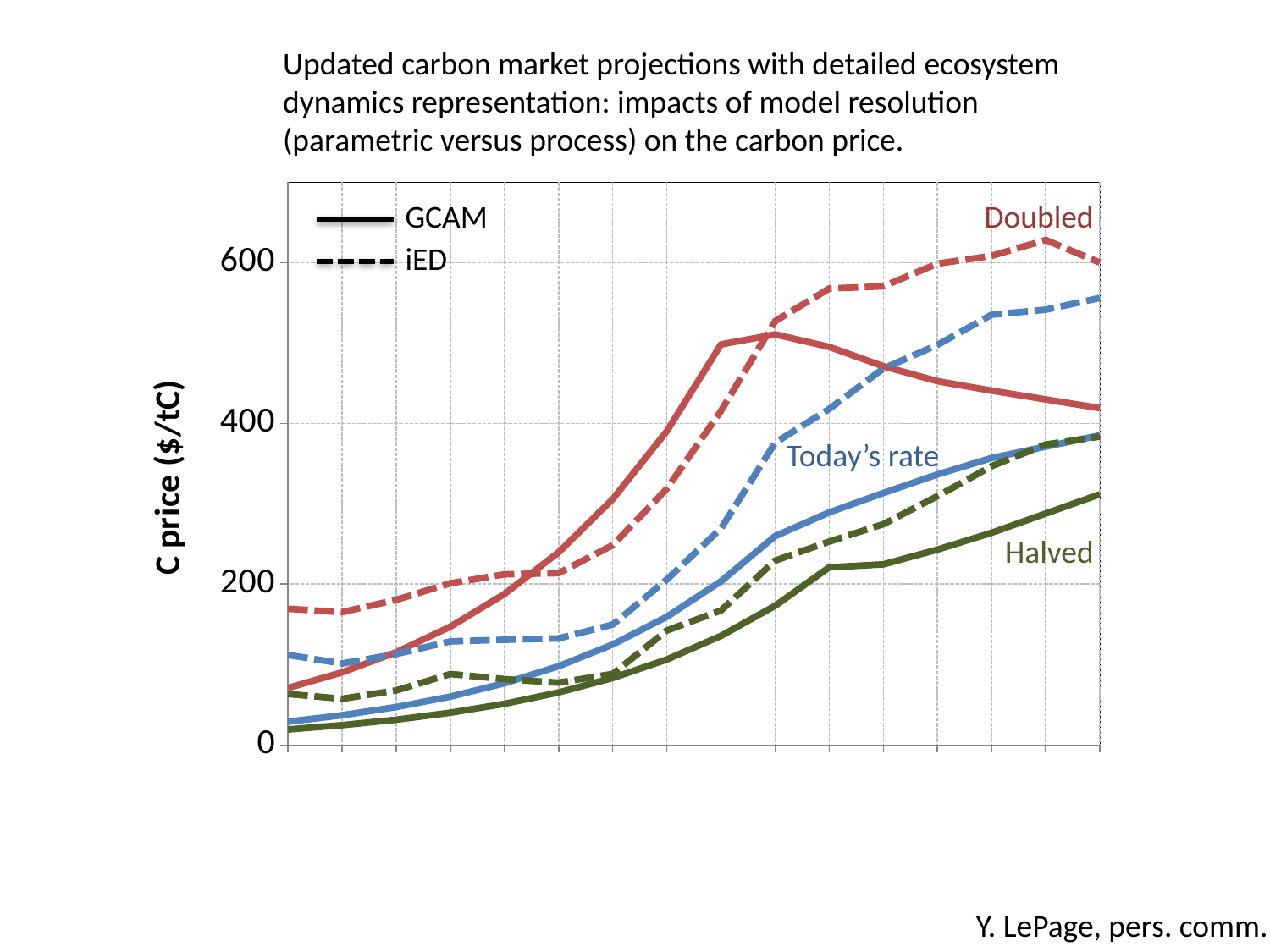
Which scenario has the lowest carbon price in the chart? Halved What is the label on the y axis of the chart? C price ($/tC) Is the value at the right end of the dashed red iED Doubled line greater or less than 400? greater Is the value at the left end of the dashed red iED Doubled line greater or less than 200? less How many entries does the chart's legend list? 2 Which scenario reaches the highest carbon price in the chart? Doubled Is the peak value of the solid red GCAM Doubled line greater or less than 400? greater Does the solid green GCAM Halved line rise or fall along the x axis? rise Which line style represents iED in the chart? dashed At the right end of the chart, which is higher for Today's rate: the dashed iED line or the solid GCAM line? dashed iED line What kind of chart is shown on the slide? line chart